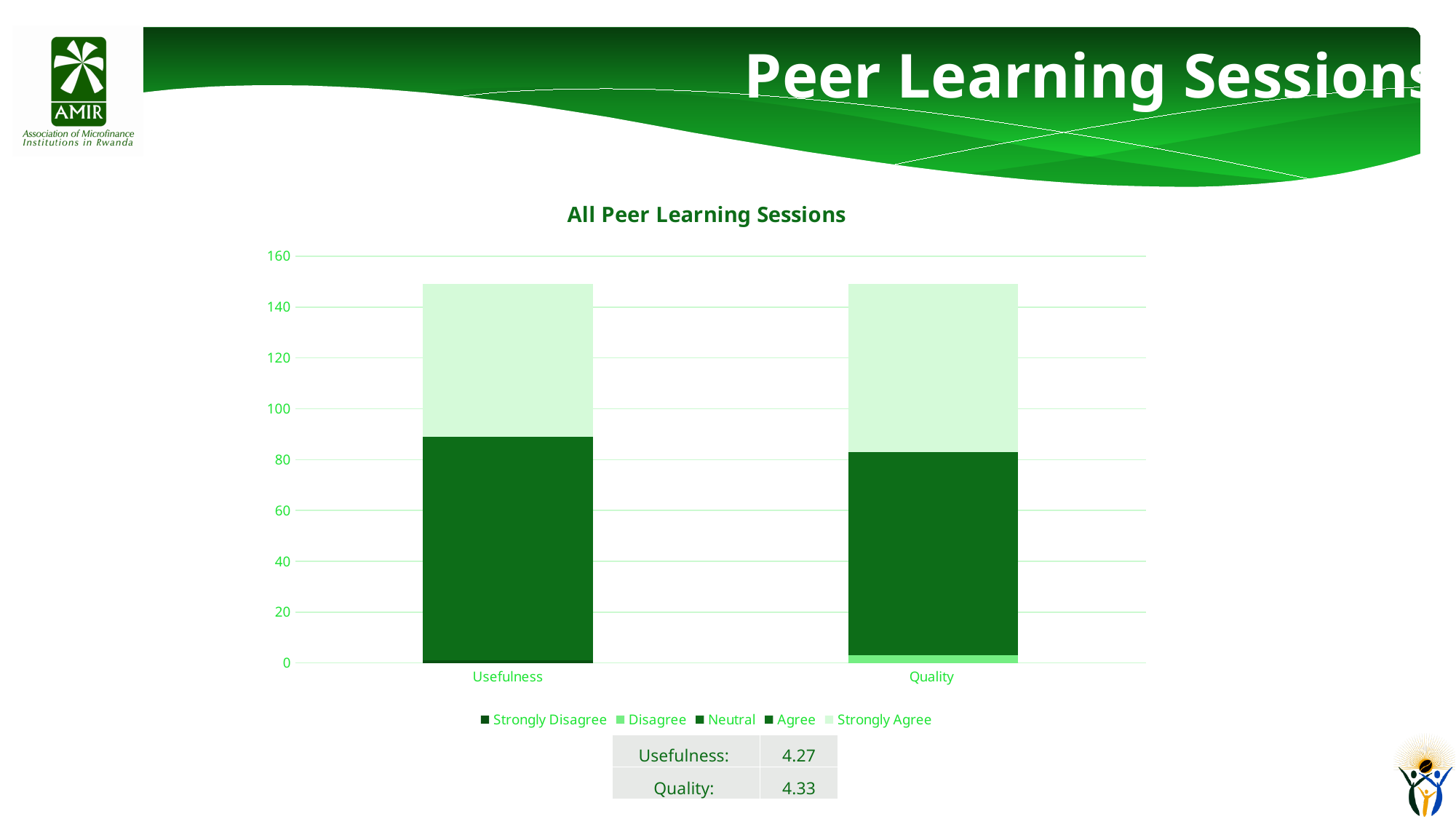
Which series is listed last in the chart legend? Strongly Agree What is the title of the chart? All Peer Learning Sessions How many categories are shown on the x axis of the chart? 2 Is the total height of the Quality bar greater or less than 160? less Is the Disagree value for Quality greater or less than 20? less What type of chart is shown on the slide? Stacked bar chart Is the Strongly Agree value for Quality greater or less than 40? greater How many series does the chart legend list? 5